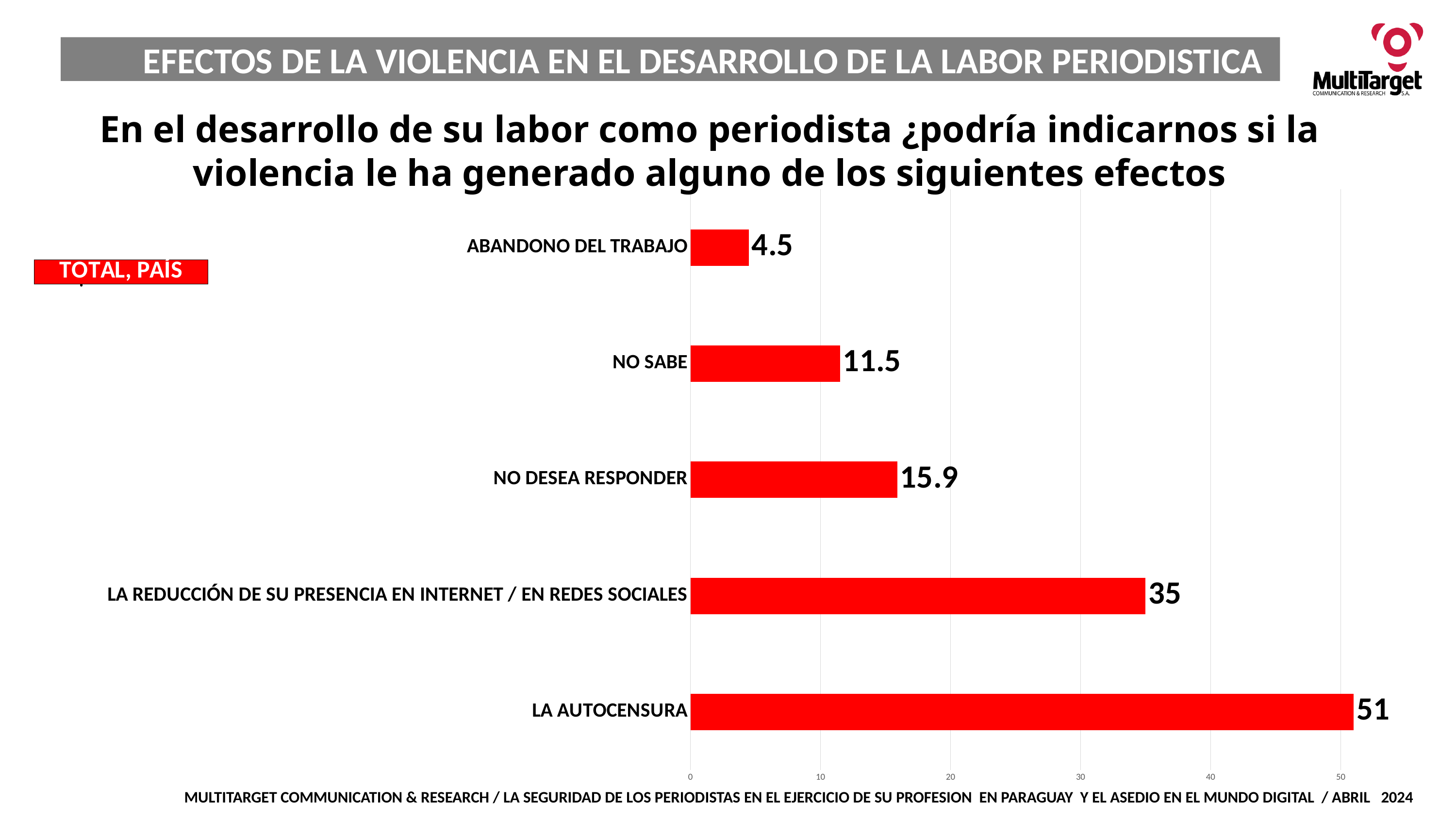
What is the difference between the values for LA AUTOCENSURA and LA REDUCCIÓN DE SU PRESENCIA EN INTERNET / EN REDES SOCIALES? 16 What is the value for ABANDONO DEL TRABAJO? 4.5 Is the value for LA REDUCCIÓN DE SU PRESENCIA EN INTERNET / EN REDES SOCIALES greater or less than 30? greater What kind of chart is shown on the slide? bar chart Which category has the highest value? LA AUTOCENSURA Which is larger, the value for NO SABE or the value for NO DESEA RESPONDER? NO DESEA RESPONDER What is the difference between the values for NO DESEA RESPONDER and NO SABE? 4.4 What is the value for LA AUTOCENSURA? 51 What is the value for NO DESEA RESPONDER? 15.9 Which category has the lowest value? ABANDONO DEL TRABAJO What is the value for LA REDUCCIÓN DE SU PRESENCIA EN INTERNET / EN REDES SOCIALES? 35 How many categories are shown in the chart? 5